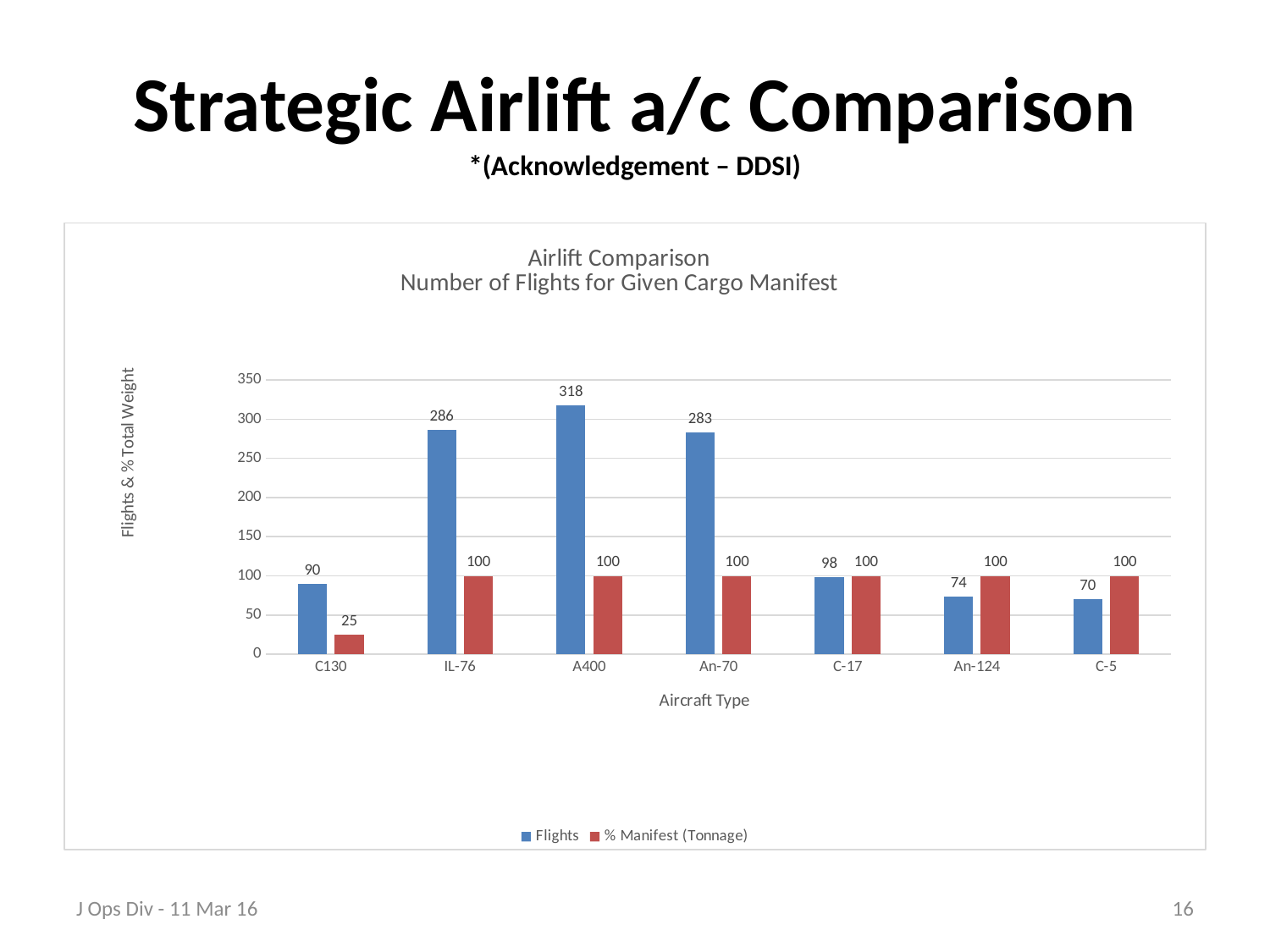
What is the difference in Flights between the A400 and the IL-76? 32 What kind of chart is shown on the slide? Bar chart How many series does the legend list? 2 How many aircraft types are shown on the x axis? 7 What is the label of the y axis? Flights & % Total Weight Which aircraft type has the lowest number of Flights? C-5 What is the number of Flights for the A400? 318 What is the number of Flights for the An-124? 74 What is the % Manifest (Tonnage) value for the C130? 25 Which has more Flights, the C-17 or the C130? C-17 Is the Flights value for the An-70 greater or less than 250? greater Which aircraft type has the highest number of Flights? A400